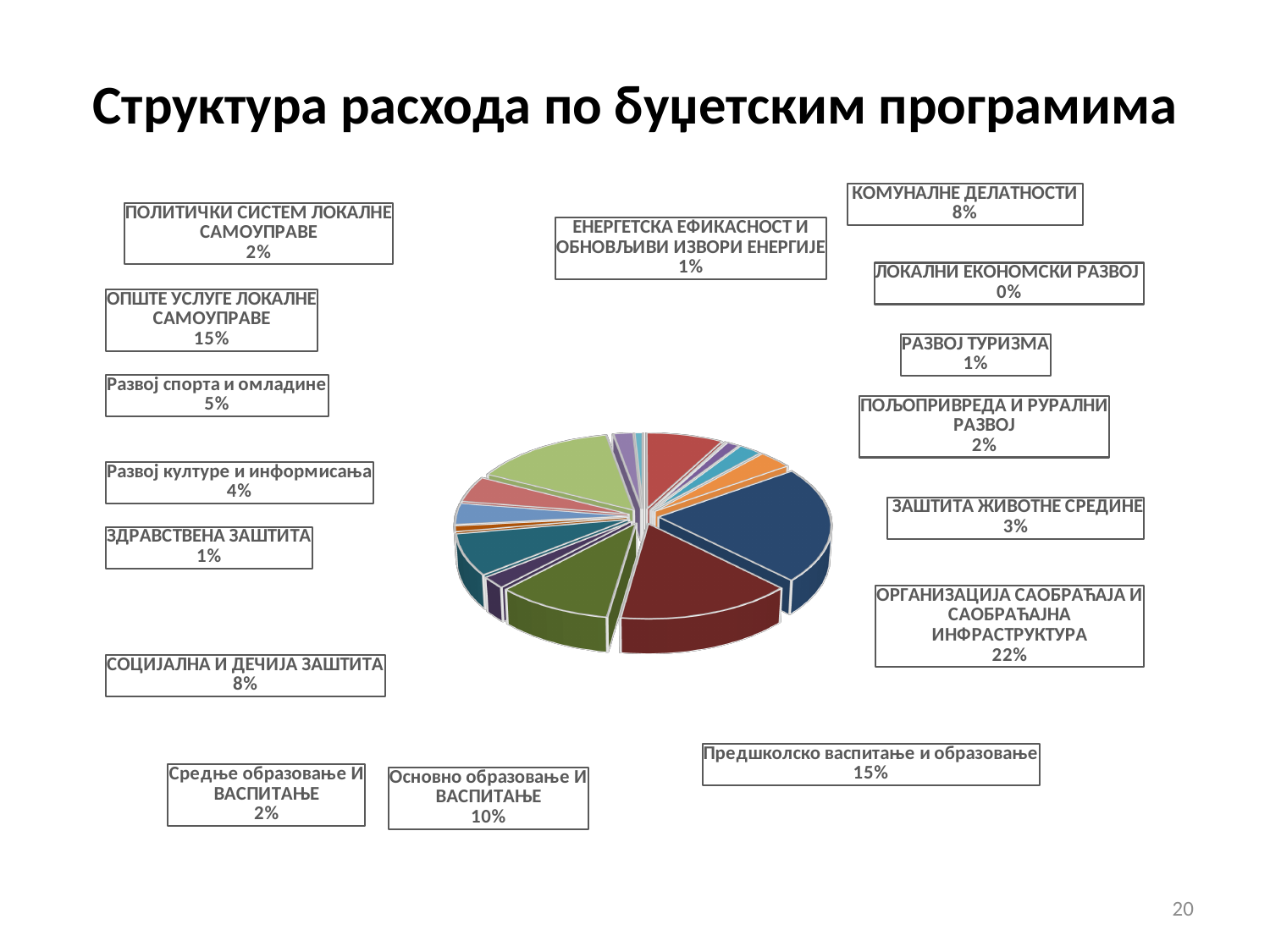
How many labelled categories does the pie chart have? 16 What share does ОРГАНИЗАЦИЈА САОБРАЋАЈА И САОБРАЋАЈНА ИНФРАСТРУКТУРА have in the pie chart? 22% What share does Предшколско васпитање и образовање have in the pie chart? 15% What kind of chart is shown on the slide? Pie chart What share does Развој спорта и омладине have in the pie chart? 5% What is the title of the chart on the slide? Структура расхода по буџетским програмима Which category has the largest share in the pie chart? ОРГАНИЗАЦИЈА САОБРАЋАЈА И САОБРАЋАЈНА ИНФРАСТРУКТУРА What is the difference in percentage points between ОРГАНИЗАЦИЈА САОБРАЋАЈА И САОБРАЋАЈНА ИНФРАСТРУКТУРА and ОПШТЕ УСЛУГЕ ЛОКАЛНЕ САМОУПРАВЕ? 7 percentage points What share does КОМУНАЛНЕ ДЕЛАТНОСТИ have in the pie chart? 8% What share does Основно образовање И ВАСПИТАЊЕ have in the pie chart? 10% Which has the larger share: Основно образовање И ВАСПИТАЊЕ or СОЦИЈАЛНА И ДЕЧИЈА ЗАШТИТА? Основно образовање И ВАСПИТАЊЕ Which category has the smallest share in the pie chart? ЛОКАЛНИ ЕКОНОМСКИ РАЗВОЈ